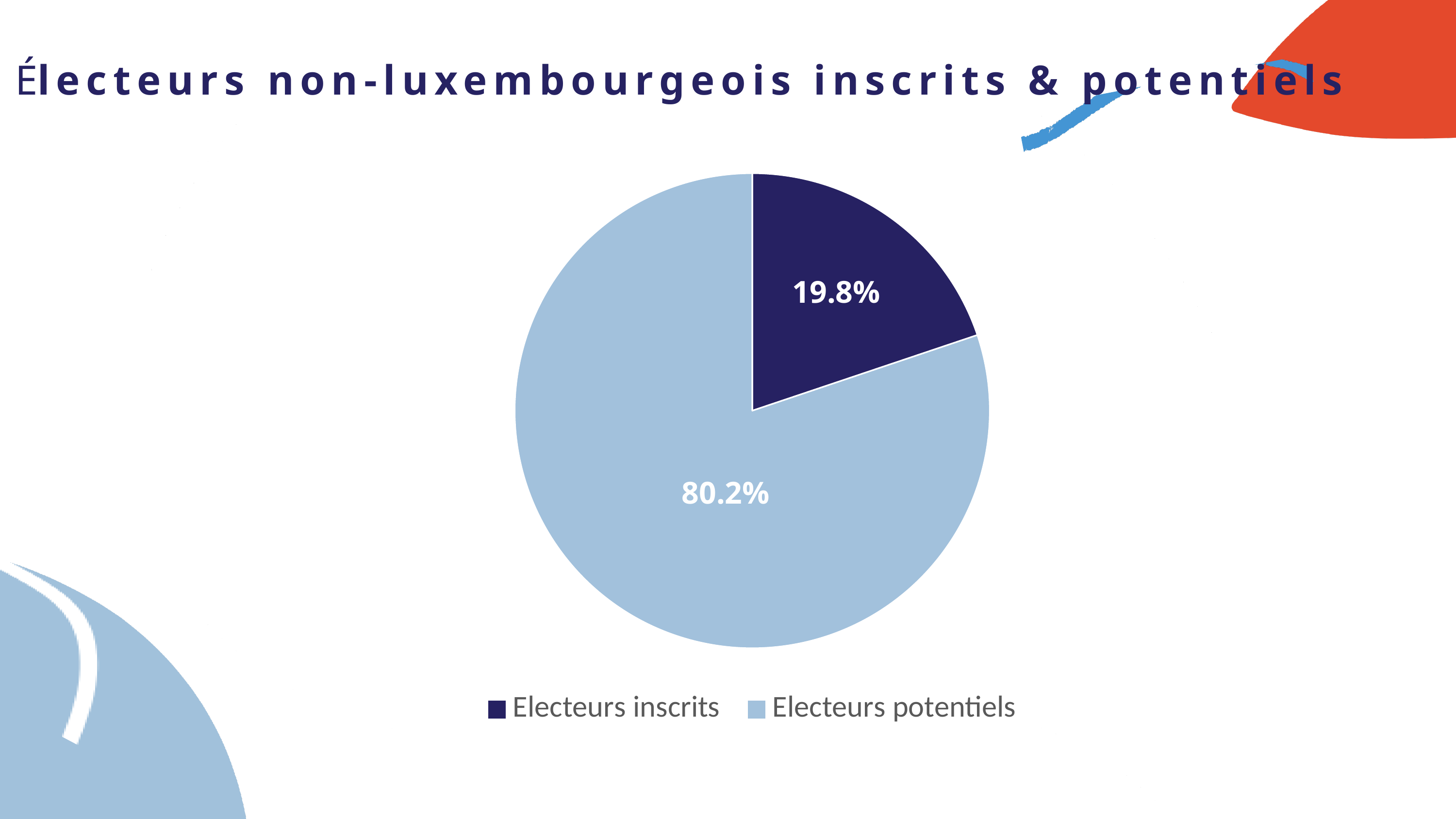
Which colour represents Electeurs inscrits in the pie chart? dark navy blue Which category has the largest slice of the pie? Electeurs potentiels What is the difference in percentage points between Electeurs potentiels and Electeurs inscrits? 60.4 How many entries does the legend list? 2 What share of the pie does Electeurs potentiels represent? 80.2% How many slices does the pie chart have? 2 What is the title of the slide containing the chart? Électeurs non-luxembourgeois inscrits & potentiels What share of the pie does Electeurs inscrits represent? 19.8% Which is larger, the slice for Electeurs inscrits or the slice for Electeurs potentiels? Electeurs potentiels What type of chart is shown on the slide? pie chart Which category has the smallest slice of the pie? Electeurs inscrits